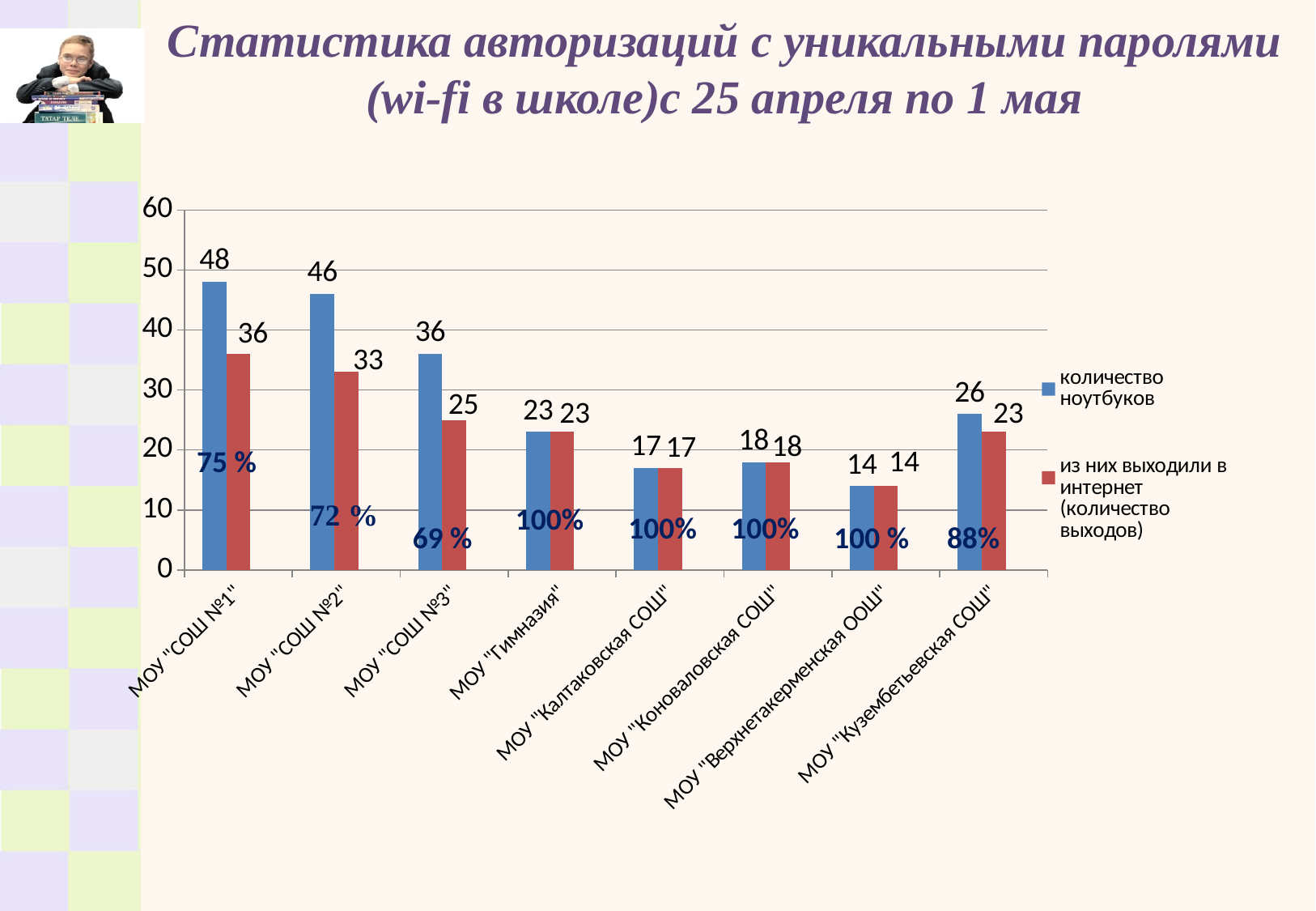
What is the value of "из них выходили в интернет (количество выходов)" for МОУ "СОШ №2"? 33 Which school has the lowest value for "количество ноутбуков"? МОУ "Верхнетакерменская ООШ" Which is larger: "количество ноутбуков" for МОУ "СОШ №2" or for МОУ "Гимназия"? МОУ "СОШ №2" What type of chart is shown on the slide? bar chart What is the difference between "количество ноутбуков" and "из них выходили в интернет" for МОУ "СОШ №3"? 11 How many series does the legend list? 2 What percentage is printed on the bars for МОУ "Кузембетьевская СОШ"? 88% Which school has the highest value for "количество ноутбуков"? МОУ "СОШ №1" How many schools (categories) are shown on the x axis? 8 What is the value of "количество ноутбуков" for МОУ "СОШ №1"? 48 What colour are the bars for the series "количество ноутбуков"? blue What is the value of "из них выходили в интернет (количество выходов)" for МОУ "Кузембетьевская СОШ"? 23